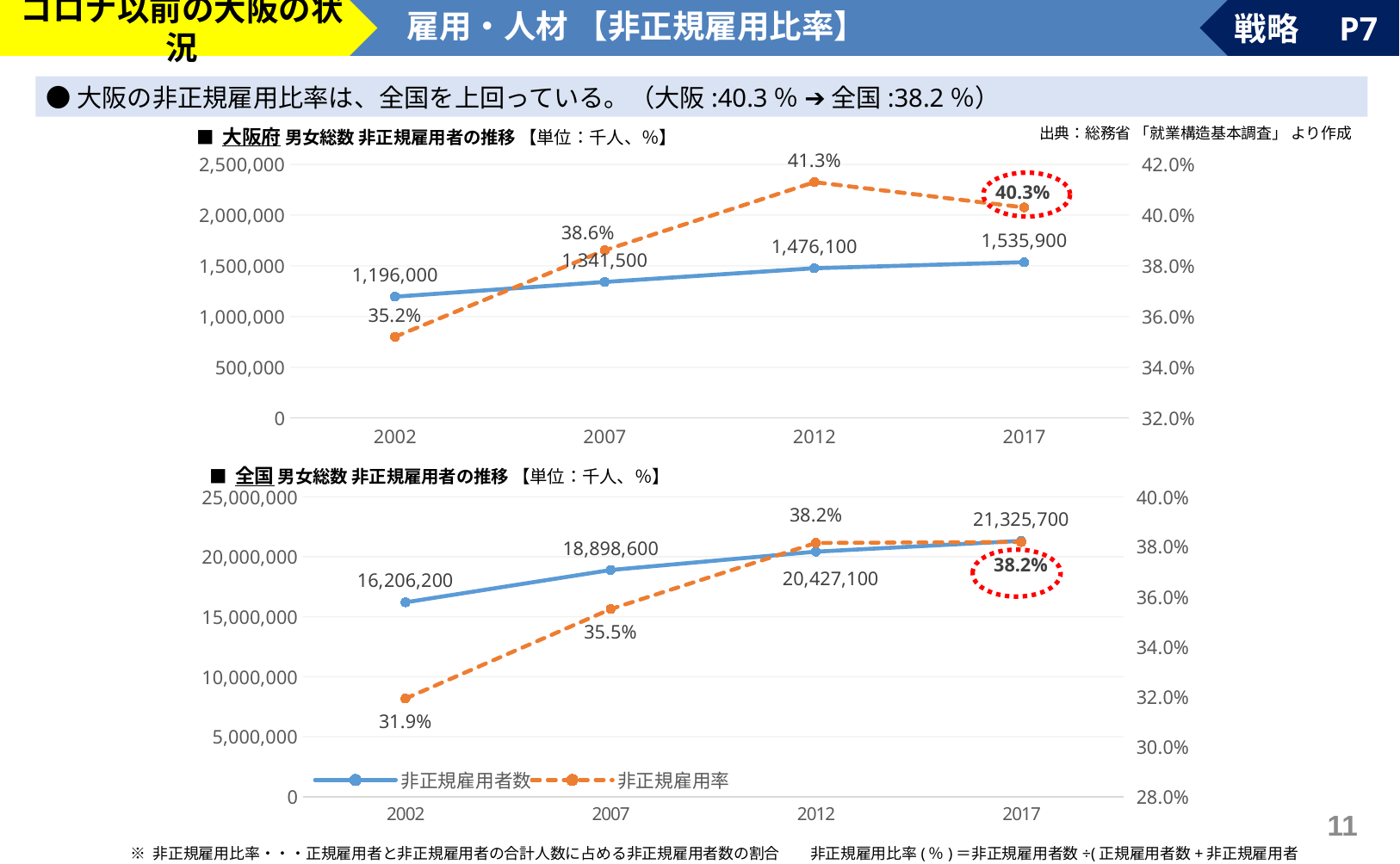
In the top chart (大阪府), which year has the highest 非正規雇用率? 2012 In the bottom chart (全国), what is the difference in 非正規雇用率 between 2007 and 2002? 3.6% How many years are plotted on the x axis of the top chart (大阪府)? 4 How many series does the legend of the bottom chart (全国) list? 2 In the bottom chart (全国 男女総数 非正規雇用者の推移), what is the 非正規雇用率 in 2002? 31.9% In the top chart (大阪府 男女総数 非正規雇用者の推移), what is the value of 非正規雇用者数 in 2017? 1,535,900 Which is larger: the 2017 非正規雇用率 in the top chart (大阪府) or in the bottom chart (全国)? 大阪府 (40.3%) In the top chart (大阪府), what is the 非正規雇用率 in 2012? 41.3% In the bottom chart (全国), does 非正規雇用者数 rise or fall from 2002 to 2017? rise In the bottom chart (全国), what is the value of 非正規雇用者数 in 2012? 20,427,100 In the top chart (大阪府), which year has the lowest 非正規雇用者数? 2002 In the top chart (大阪府), what is the difference in 非正規雇用者数 between 2017 and 2002? 339,900